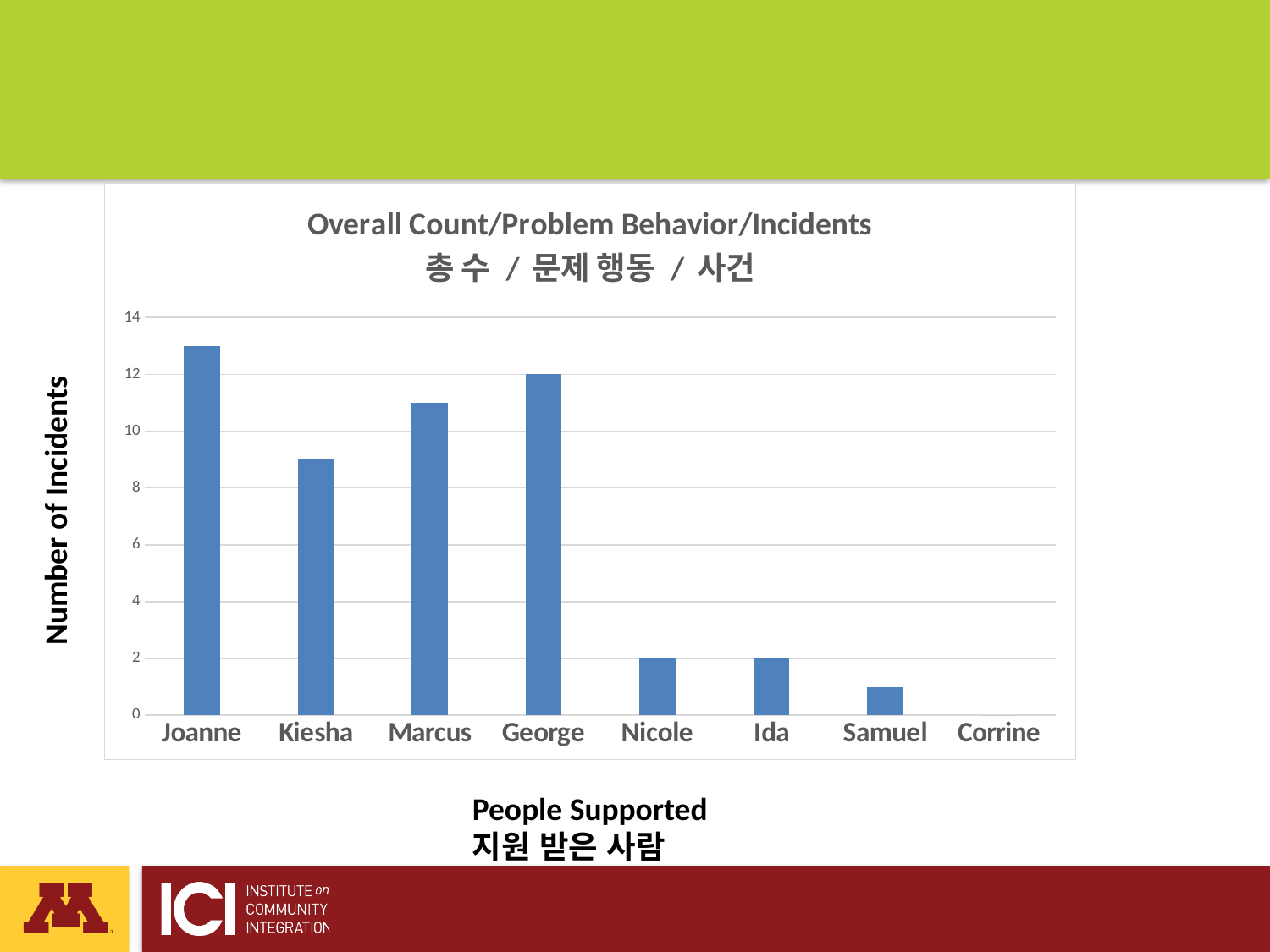
Is the value for Samuel greater or less than 2? less Who has more incidents, Marcus or Kiesha? Marcus Is the value for Joanne greater or less than 12? greater What is the number of incidents for George? 12 What is the difference between the number of incidents for George and for Nicole? 10 Is the value for Kiesha greater or less than 10? less What type of chart is shown on the slide? bar chart What is the number of incidents for Ida? 2 Which person has the highest number of incidents? Joanne What is the number of incidents for Nicole? 2 Which person has the lowest number of incidents? Corrine How many people are shown on the x axis of the chart? 8